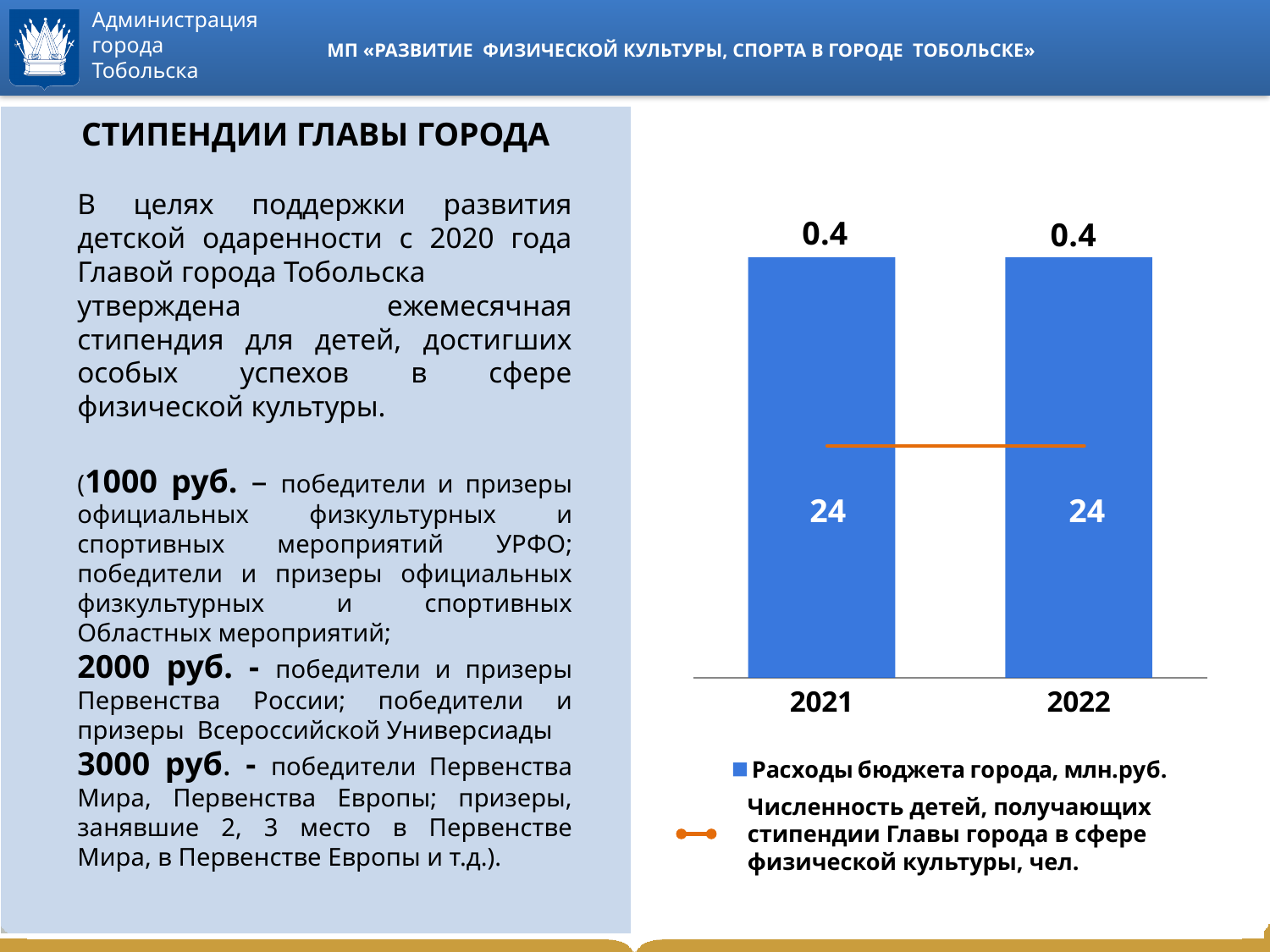
What is the difference between the city budget expenses in 2022 and 2021? 0 What is the difference in the number of children receiving scholarships between 2021 and 2022? 0 What is the value of 'Расходы бюджета города, млн.руб.' for 2021? 0.4 How many series does the chart legend list? 2 What kind of chart is shown on the slide? Combined bar and line chart How many children receiving the Head of City scholarship are shown for 2021? 24 What colour is the line representing the number of children receiving scholarships? Orange How many years (categories) are shown on the x axis of the chart? 2 How many children receiving the Head of City scholarship are shown for 2022? 24 Which series is shown as blue bars in the chart? Расходы бюджета города, млн.руб. Do the city budget expenses rise, fall or stay the same from 2021 to 2022? Stay the same What is the value of 'Расходы бюджета города, млн.руб.' for 2022? 0.4